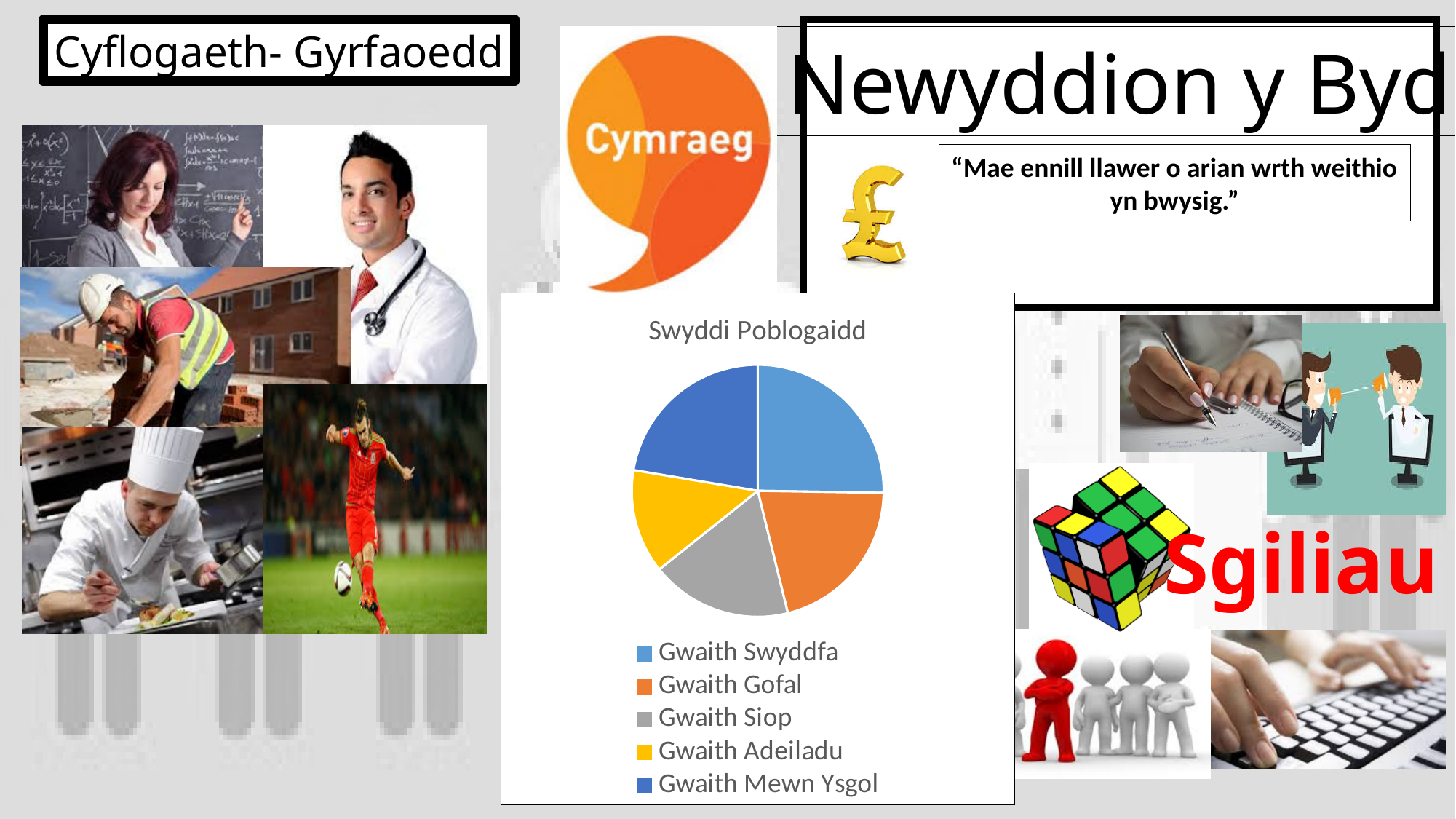
In the "Swyddi Poblogaidd" pie chart, which slice is larger: Gwaith Mewn Ysgol or Gwaith Adeiladu? Gwaith Mewn Ysgol What kind of chart is shown under the title "Swyddi Poblogaidd"? pie chart Which category is listed last in the legend of the "Swyddi Poblogaidd" pie chart? Gwaith Mewn Ysgol Which category has the largest slice in the "Swyddi Poblogaidd" pie chart? Gwaith Swyddfa Which colour represents Gwaith Gofal in the "Swyddi Poblogaidd" pie chart? orange In the "Swyddi Poblogaidd" pie chart, which slice is larger: Gwaith Gofal or Gwaith Adeiladu? Gwaith Gofal How many categories (slices) does the "Swyddi Poblogaidd" pie chart have? 5 What is the title of the pie chart on the slide? Swyddi Poblogaidd In the "Swyddi Poblogaidd" pie chart, which slice is larger: Gwaith Swyddfa or Gwaith Siop? Gwaith Swyddfa